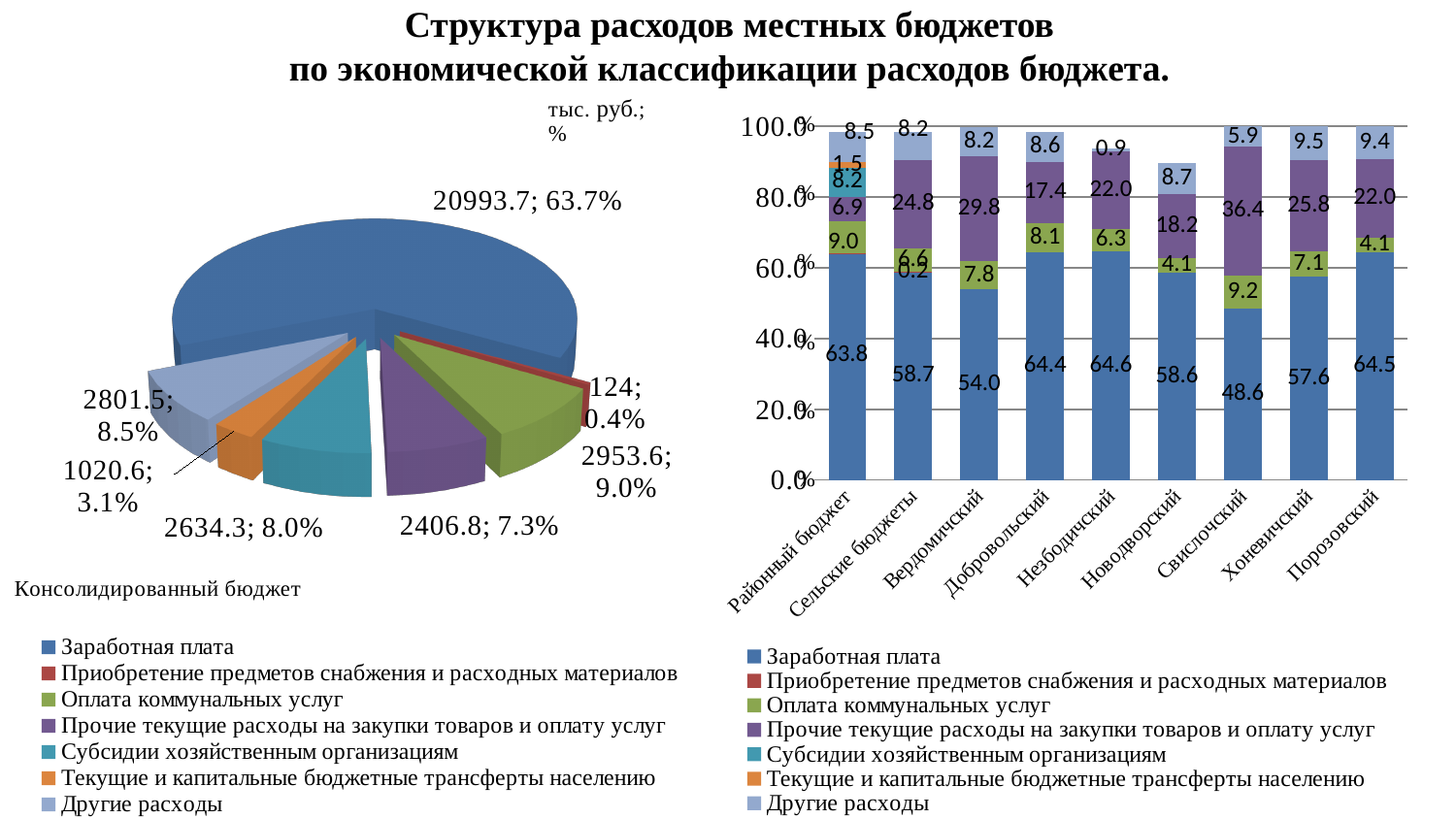
On the stacked bar chart on the right, what is the difference between the Заработная плата values for Районный бюджет and Сельские бюджеты? 5.1 On the pie chart (Консолидированный бюджет), which is larger: Субсидии хозяйственным организациям or Прочие текущие расходы на закупки товаров и оплату услуг? Субсидии хозяйственным организациям On the stacked bar chart on the right, how many series does the legend list? 7 On the pie chart (Консолидированный бюджет), how many slices are there? 7 On the pie chart (Консолидированный бюджет), what is the value shown for Другие расходы? 2801.5 On the pie chart (Консолидированный бюджет), what value and share are shown for Заработная плата? 20993.7; 63.7% On the pie chart (Консолидированный бюджет), which category has the smallest slice? Приобретение предметов снабжения и расходных материалов On the pie chart (Консолидированный бюджет), what share does Оплата коммунальных услуг have? 9.0% On the stacked bar chart on the right, what is the value of Заработная плата for Свислочский? 48.6 On the stacked bar chart on the right, which category has the highest value for Прочие текущие расходы на закупки товаров и оплату услуг? Свислочский On the stacked bar chart on the right, which category has the lowest value for Заработная плата? Свислочский On the stacked bar chart on the right, how many categories are shown on the x axis? 9